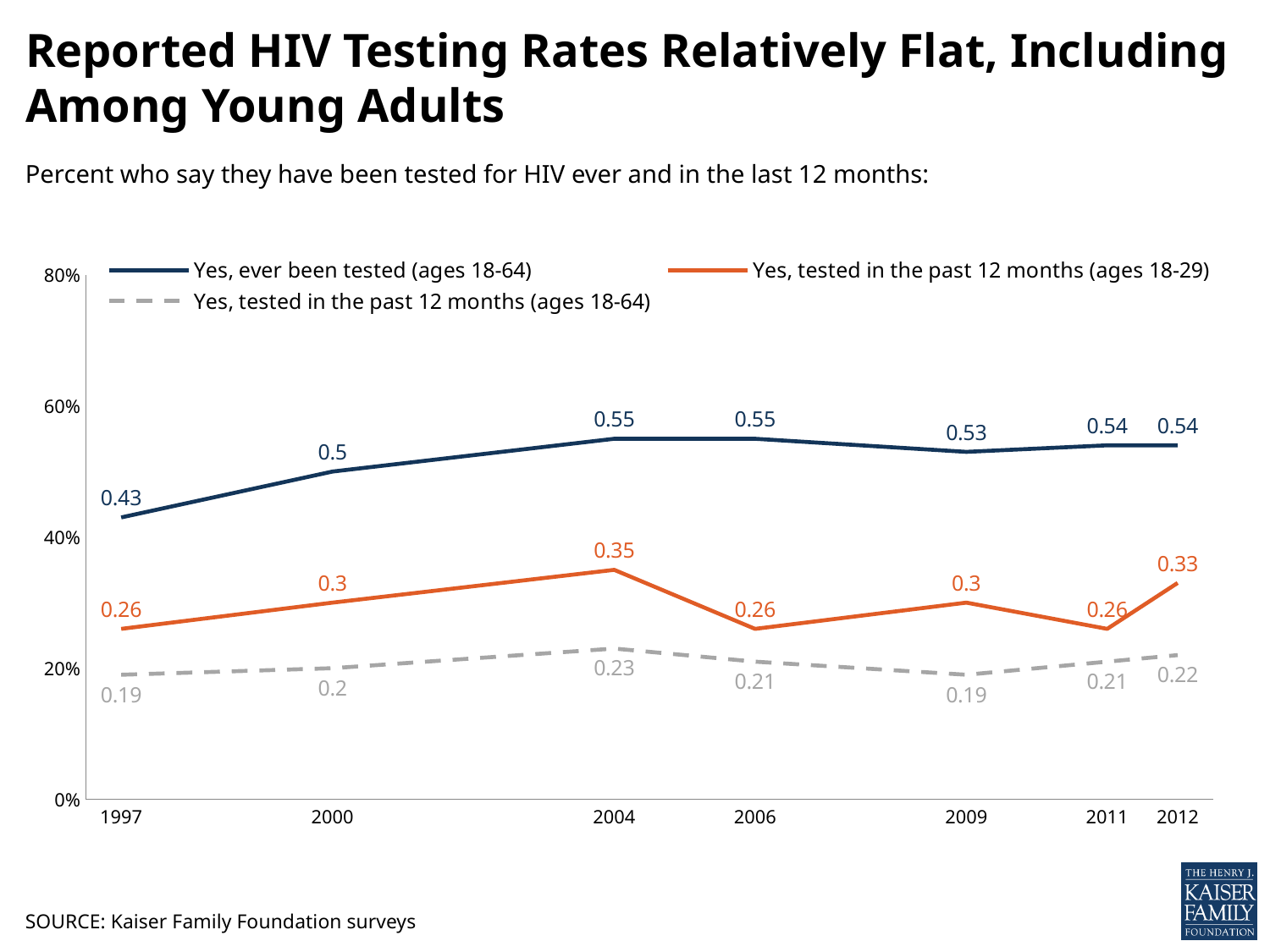
How many series does the legend list? 3 What is the value for "Yes, tested in the past 12 months (ages 18-64)" in 2012? 0.22 Is the 2004 value for "Yes, ever been tested (ages 18-64)" greater or less than 40%? greater In 2009, which is larger: the value for ages 18-29 tested in the past 12 months or the value for ages 18-64 tested in the past 12 months? Ages 18-29 tested in the past 12 months In which year is the "Yes, ever been tested (ages 18-64)" series at its lowest? 1997 In which year is the "Yes, tested in the past 12 months (ages 18-29)" series at its highest? 2004 What is the difference between the 2012 and 1997 values for "Yes, ever been tested (ages 18-64)"? 0.11 What is the value for "Yes, ever been tested (ages 18-64)" in 1997? 0.43 What kind of chart is shown on the slide? Line chart What is the value for "Yes, tested in the past 12 months (ages 18-29)" in 2004? 0.35 How many years are shown on the x axis? 7 Does the "Yes, ever been tested (ages 18-64)" series rise or fall from 1997 to 2004? Rise